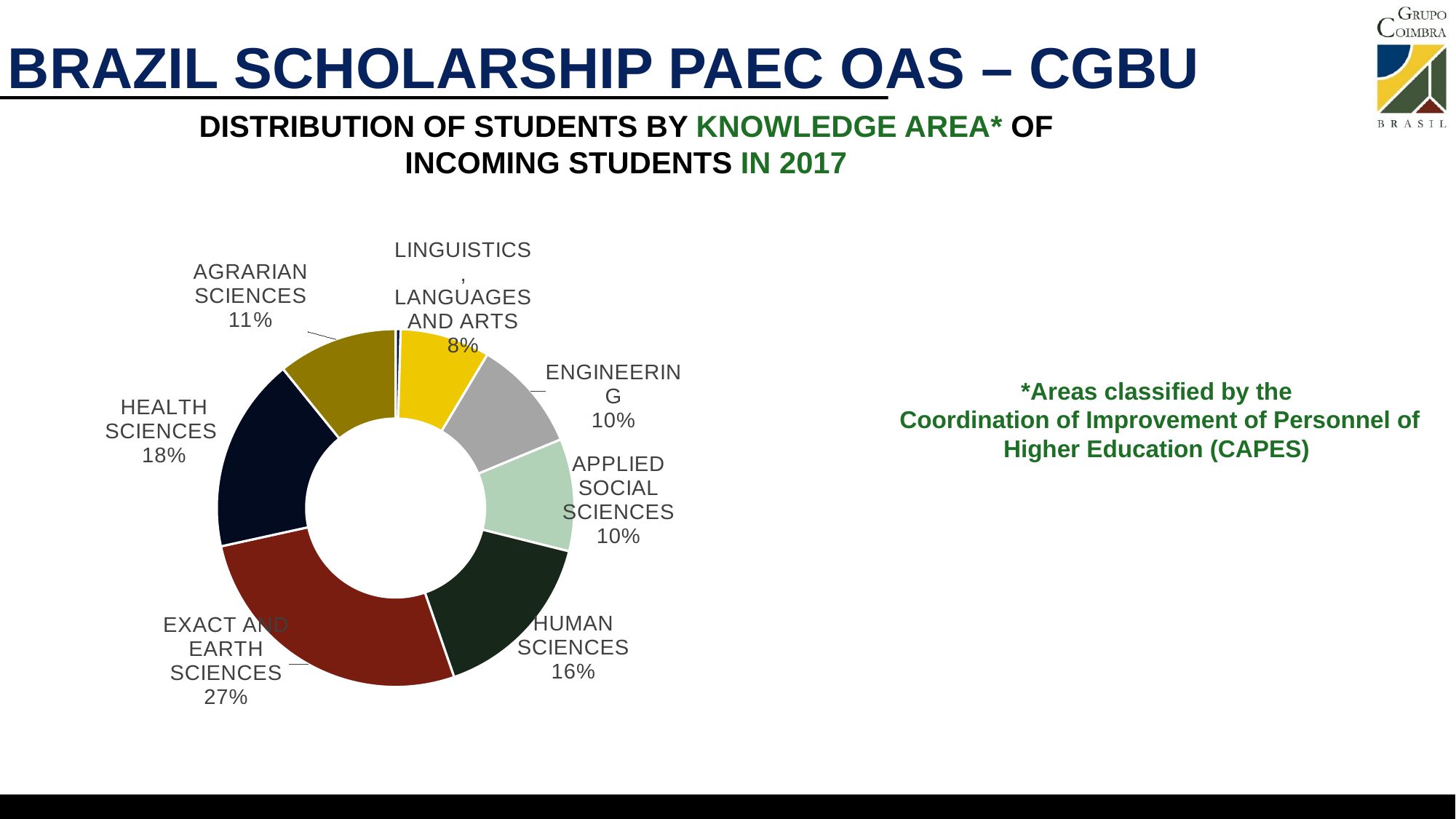
Which has a larger share, Human Sciences or Agrarian Sciences? Human Sciences What percentage is shown for Linguistics, Languages and Arts? 8% What is the difference in percentage points between Exact and Earth Sciences and Health Sciences? 9 What percentage is shown for Agrarian Sciences? 11% What percentage of incoming students is in Health Sciences? 18% What share of the chart does Human Sciences represent? 16% What type of chart is used to show the distribution of students by knowledge area? Doughnut chart Which knowledge area has the largest share of incoming students? Exact and Earth Sciences What share of incoming students in 2017 is in Exact and Earth Sciences? 27% Which two knowledge areas each have a 10% share? Engineering and Applied Social Sciences